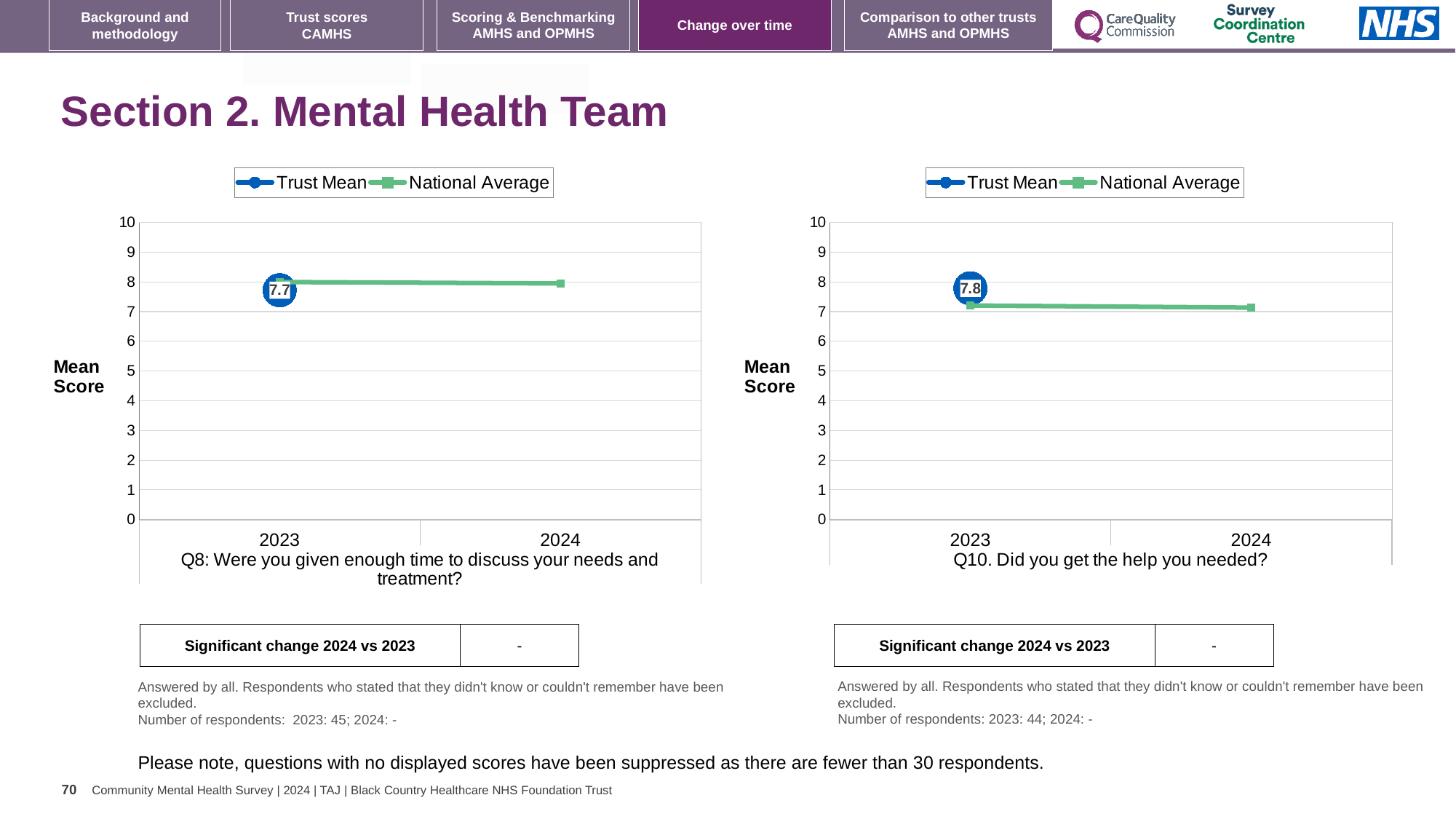
What kind of chart is the right chart (Q10)? Line chart In the right chart (Q10), is the National Average value for 2023 greater or less than 6? greater In the right chart (Q10), which is larger for 2023: the Trust Mean or the National Average? Trust Mean In the right chart (Q10), is the National Average value for 2024 greater or less than 8? less In the left chart (Q8: Were you given enough time to discuss your needs and treatment?), what is the Trust Mean for 2023? 7.7 How many years are shown on the x axis of the left chart (Q8)? 2 How many series does the legend of the left chart (Q8) list? 2 What is the y-axis label on the left chart (Q8)? Mean Score In the left chart (Q8), is the Trust Mean for 2023 greater or less than 5? greater In the right chart (Q10. Did you get the help you needed?), what is the Trust Mean for 2023? 7.8 What are the two series named in the legend of the right chart (Q10)? Trust Mean and National Average